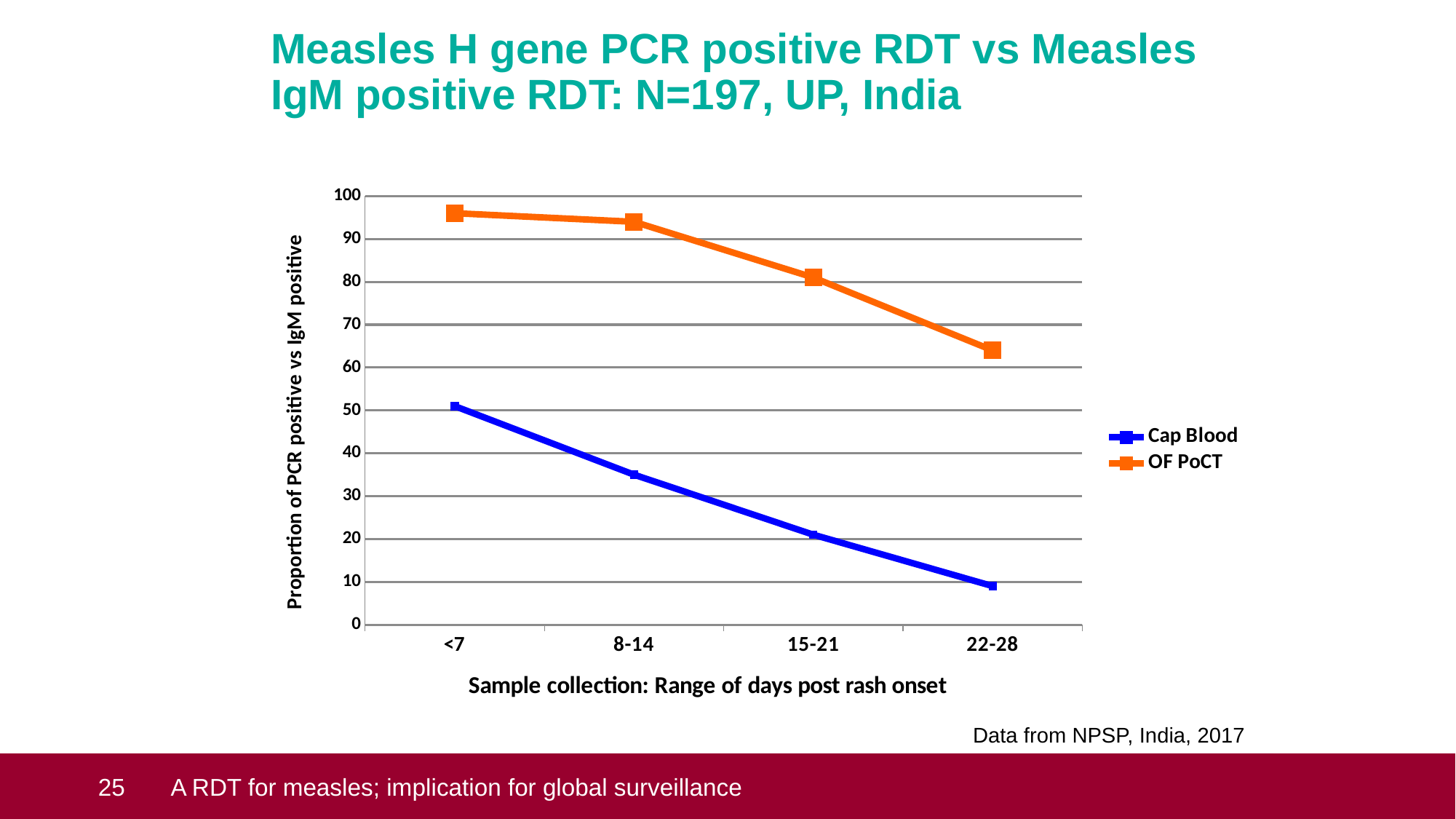
Is the OF PoCT value for 22-28 days greater or less than 70? less How many series does the legend list? 2 For which day range is the OF PoCT value lowest? 22-28 Which series has the higher value at 22-28 days, Cap Blood or OF PoCT? OF PoCT What is the label of the x axis? Sample collection: Range of days post rash onset How many categories are shown on the x axis? 4 What kind of chart is shown on the slide? line chart For which day range is the Cap Blood value highest? <7 Is the Cap Blood value for 15-21 days greater or less than 30? less Is the OF PoCT value for <7 days greater or less than 90? greater Do the Cap Blood values rise or fall as the days post rash onset increase? fall